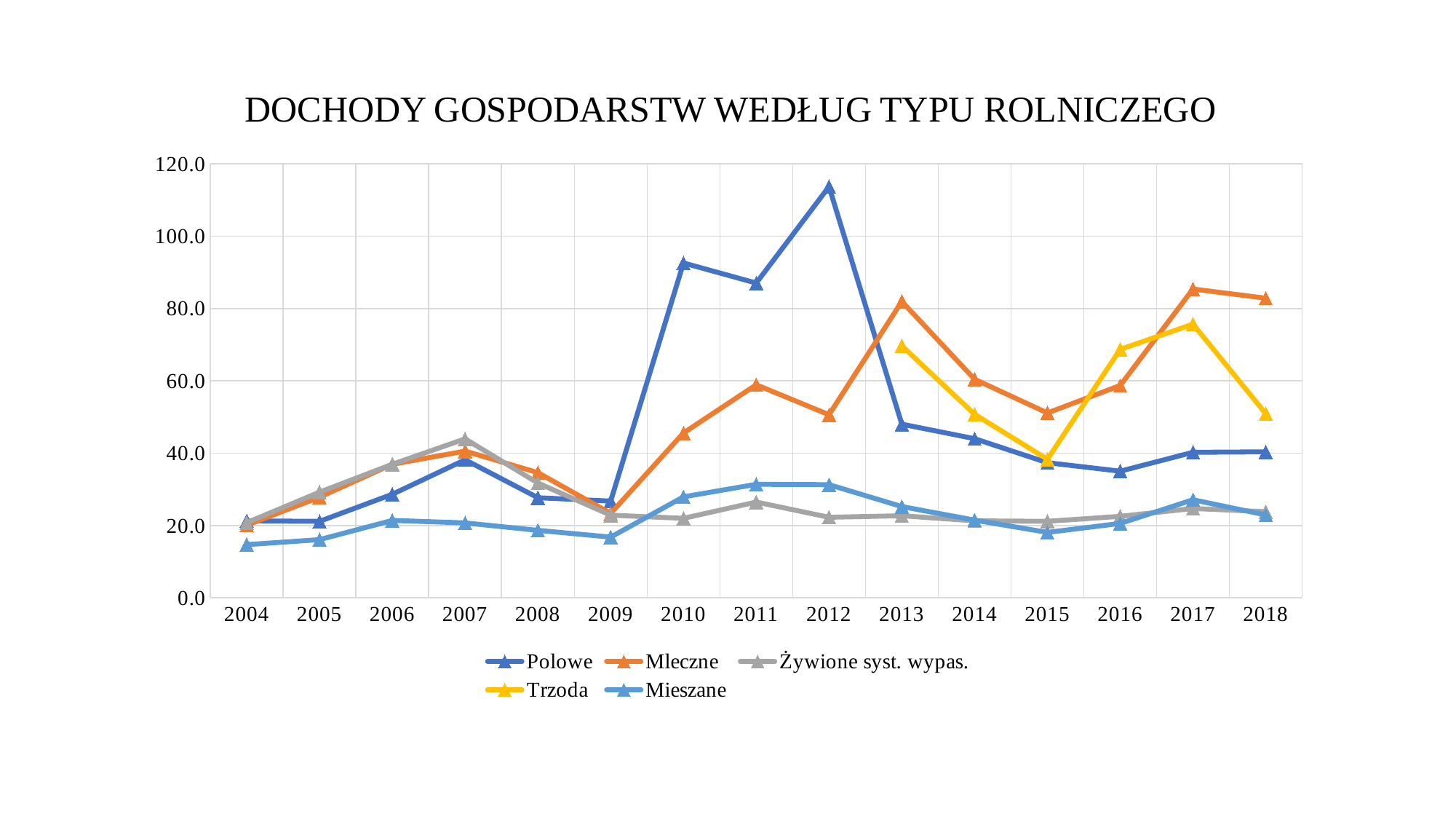
In 2018, which is larger: Trzoda or Polowe? Trzoda Does the Trzoda series rise or fall from 2017 to 2018? fall Is the value for Polowe in 2012 greater or less than 100? greater Which series has the highest value in 2010? Polowe In 2013, which is larger: Mleczne or Polowe? Mleczne What kind of chart is shown on the slide? line chart Is the value for Mieszane in 2004 greater or less than 20? less How many years are shown on the x axis? 15 Is the value for Mleczne in 2017 greater or less than 80? greater What is the title of the chart? DOCHODY GOSPODARSTW WEDŁUG TYPU ROLNICZEGO In which year does the Polowe series reach its highest value? 2012 How many series does the legend list? 5